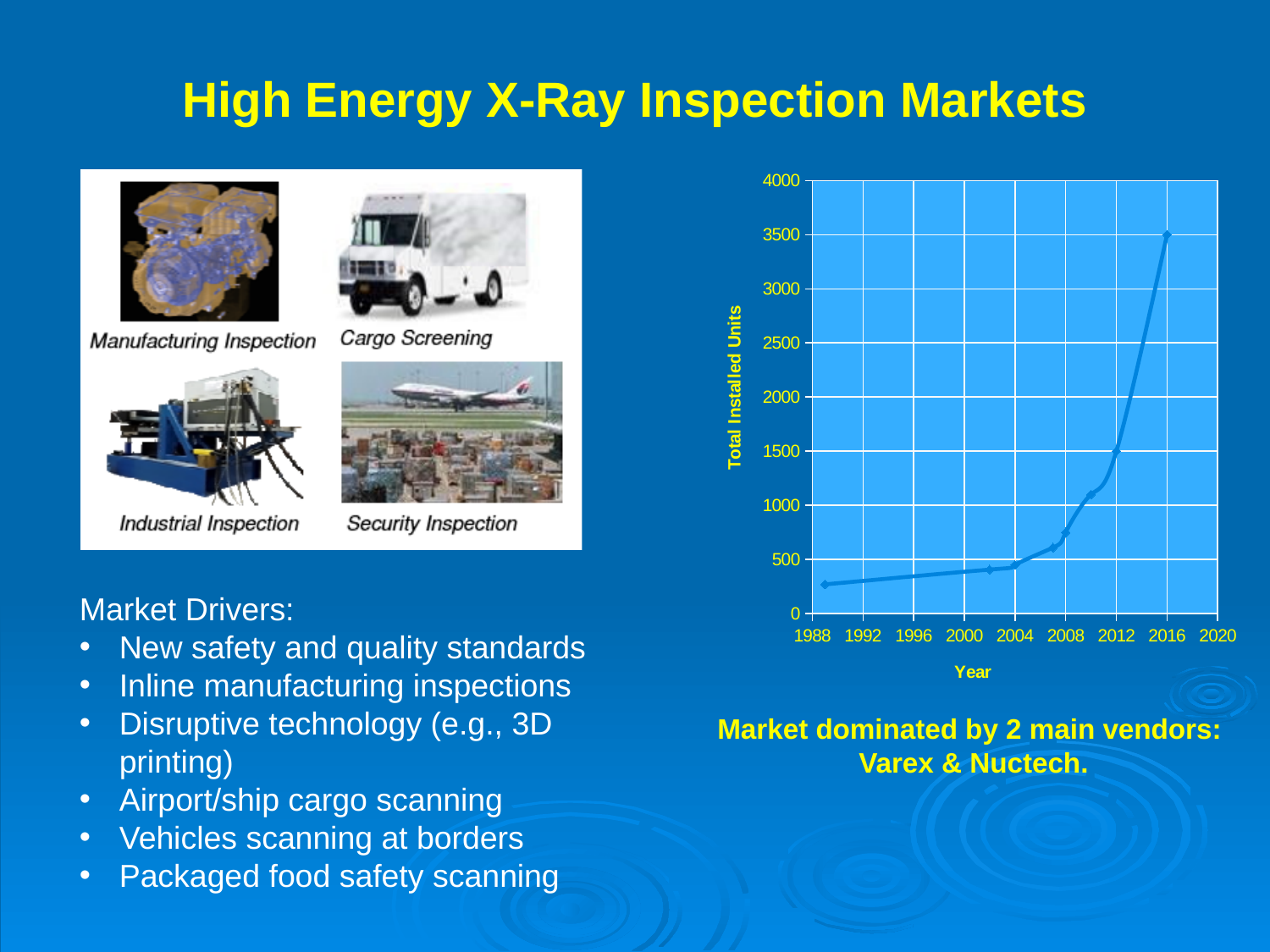
Is the value for 2004 greater or less than 1000? less Do the total installed units rise or fall as the year increases along the x axis? rise Which year has more total installed units, 2012 or 2016? 2016 Is the value for 2016 greater or less than 3000? greater Which year has the highest total installed units on the chart? 2016 What is the title of the y axis of the chart? Total Installed Units What kind of chart is shown on the slide? line chart Is the value for 2012 greater or less than 1000? greater What is the title of the x axis of the chart? Year